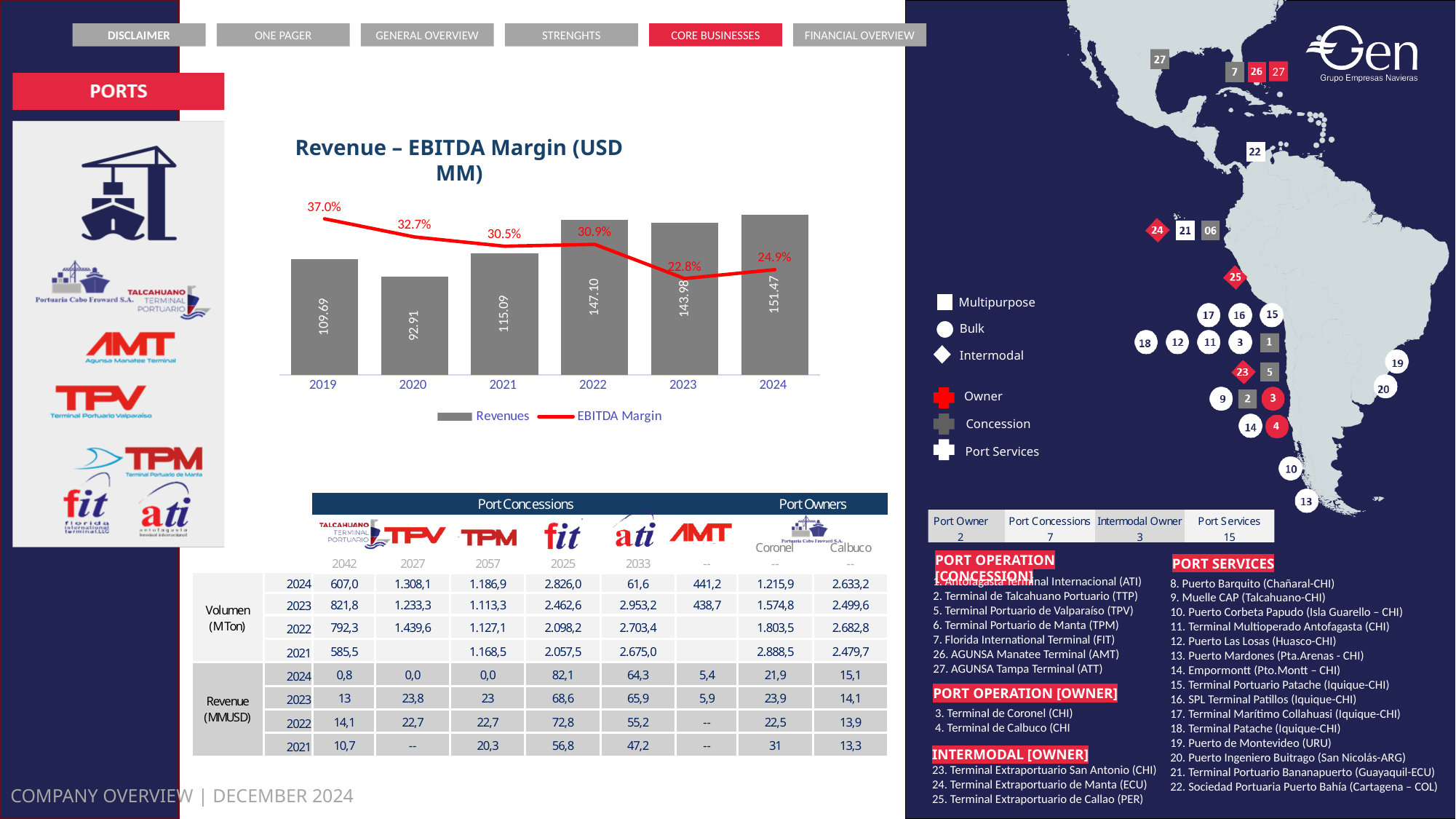
Does the EBITDA margin line generally rise or fall from 2019 to 2023 in the Revenue – EBITDA Margin chart? Fall How many series does the legend of the Revenue – EBITDA Margin chart list? 2 Which year has the lowest revenue bar in the Revenue – EBITDA Margin chart? 2020 What is the revenue value shown for 2020 in the Revenue – EBITDA Margin chart? 92.91 What type of chart is used for the Revenues series in the Revenue – EBITDA Margin chart? Bar chart Which year has the lowest EBITDA margin in the Revenue – EBITDA Margin chart? 2023 How many years are plotted on the x axis of the Revenue – EBITDA Margin chart? 6 What is the difference between the 2024 and 2023 revenue values in the Revenue – EBITDA Margin chart? 7.49 Is the revenue for 2021 or 2023 larger in the Revenue – EBITDA Margin chart? 2023 What EBITDA margin is shown for 2019 in the Revenue – EBITDA Margin chart? 37.0% Which year has the highest revenue bar in the Revenue – EBITDA Margin chart? 2024 What is the revenue value shown for 2022 in the Revenue – EBITDA Margin chart? 147.10